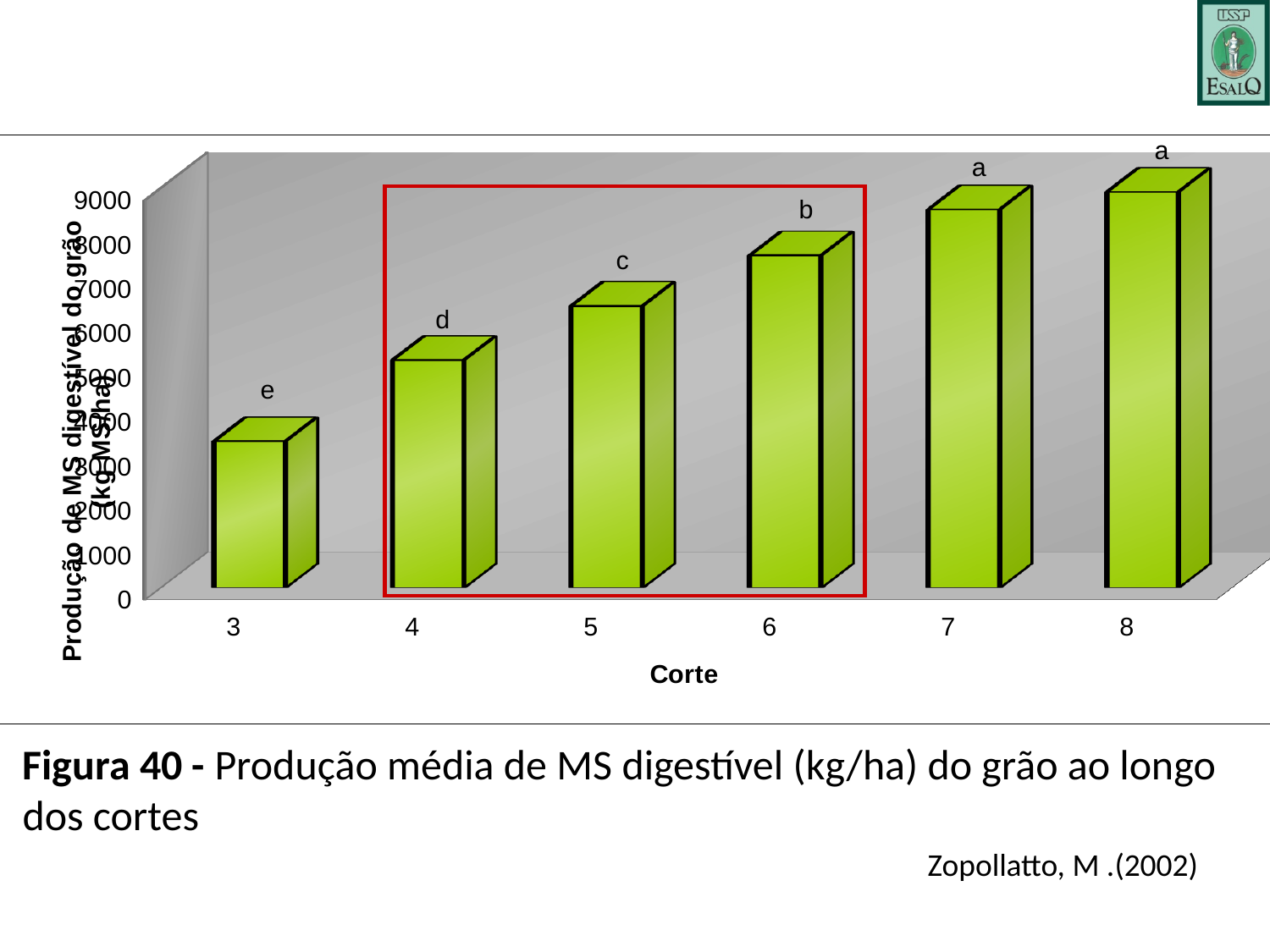
What is the title of the x axis? Corte How many cortes (categories) are plotted on the x axis? 6 Which corte has the lowest production of digestible MS? 3 Do the values rise or fall as the corte number increases from 3 to 8? rise What kind of chart is shown on the slide? bar chart Is the value for corte 4 greater or less than 5000? greater Is the value for corte 5 greater or less than 6000? greater Is the value for corte 6 greater or less than 7000? greater Which has a larger value, corte 5 or corte 4? corte 5 Which corte has the highest production of digestible MS? 8 Which letter is printed above the bar for corte 6? b